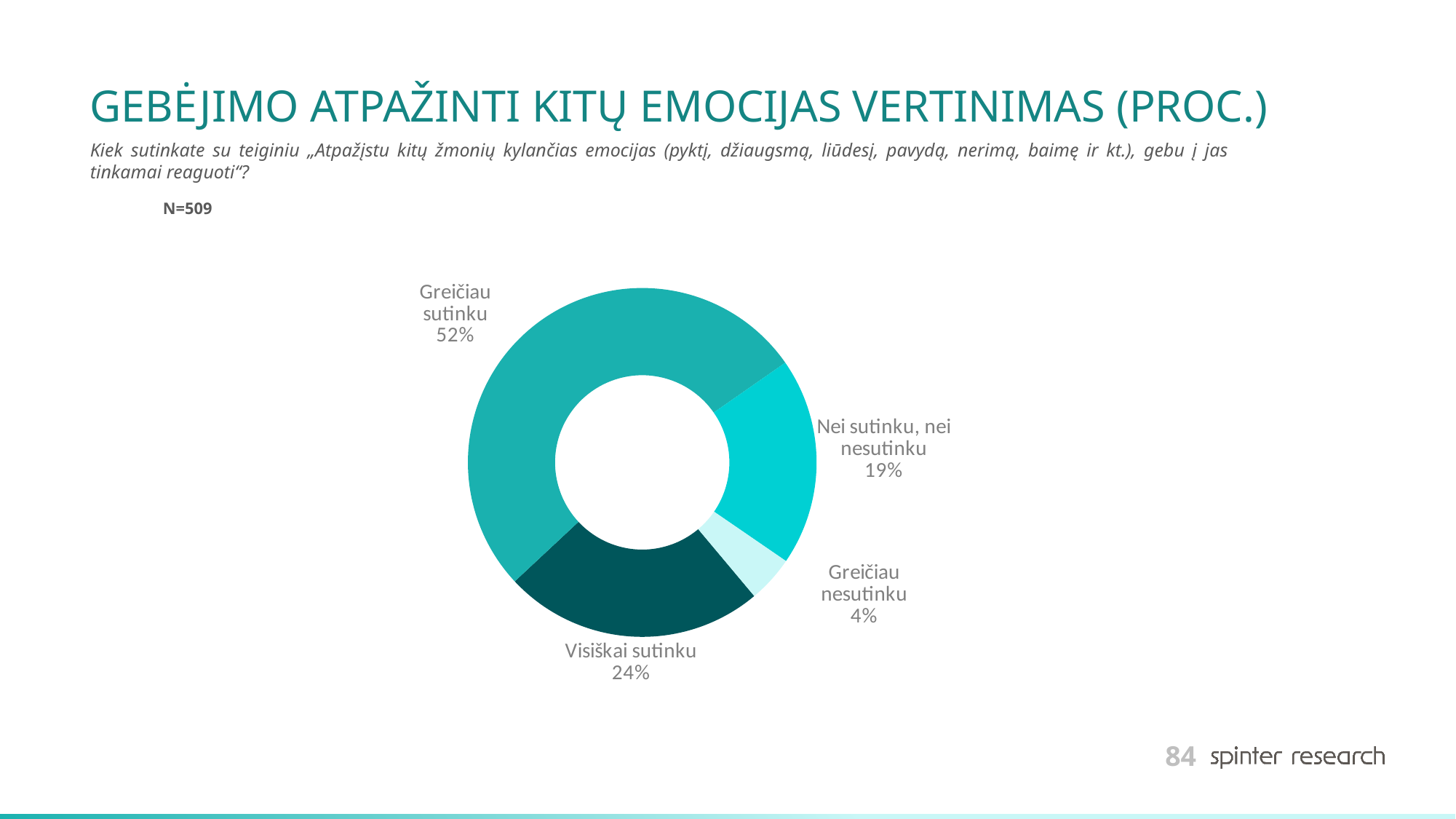
What is the sample size (N) stated on the slide? N=509 What percentage of respondents answered "Visiškai sutinku"? 24% What is the difference in percentage points between "Greičiau sutinku" and "Visiškai sutinku"? 28 What percentage of respondents answered "Greičiau nesutinku"? 4% Which response category has the largest share? Greičiau sutinku Which response category has the smallest share? Greičiau nesutinku What is the combined share of "Visiškai sutinku" and "Greičiau sutinku"? 76% What percentage of respondents answered "Greičiau sutinku"? 52% How many response categories are shown in the chart? 4 What percentage of respondents answered "Nei sutinku, nei nesutinku"? 19% What kind of chart is shown on the slide? Doughnut (pie) chart Which is larger: the share for "Visiškai sutinku" or for "Nei sutinku, nei nesutinku"? Visiškai sutinku